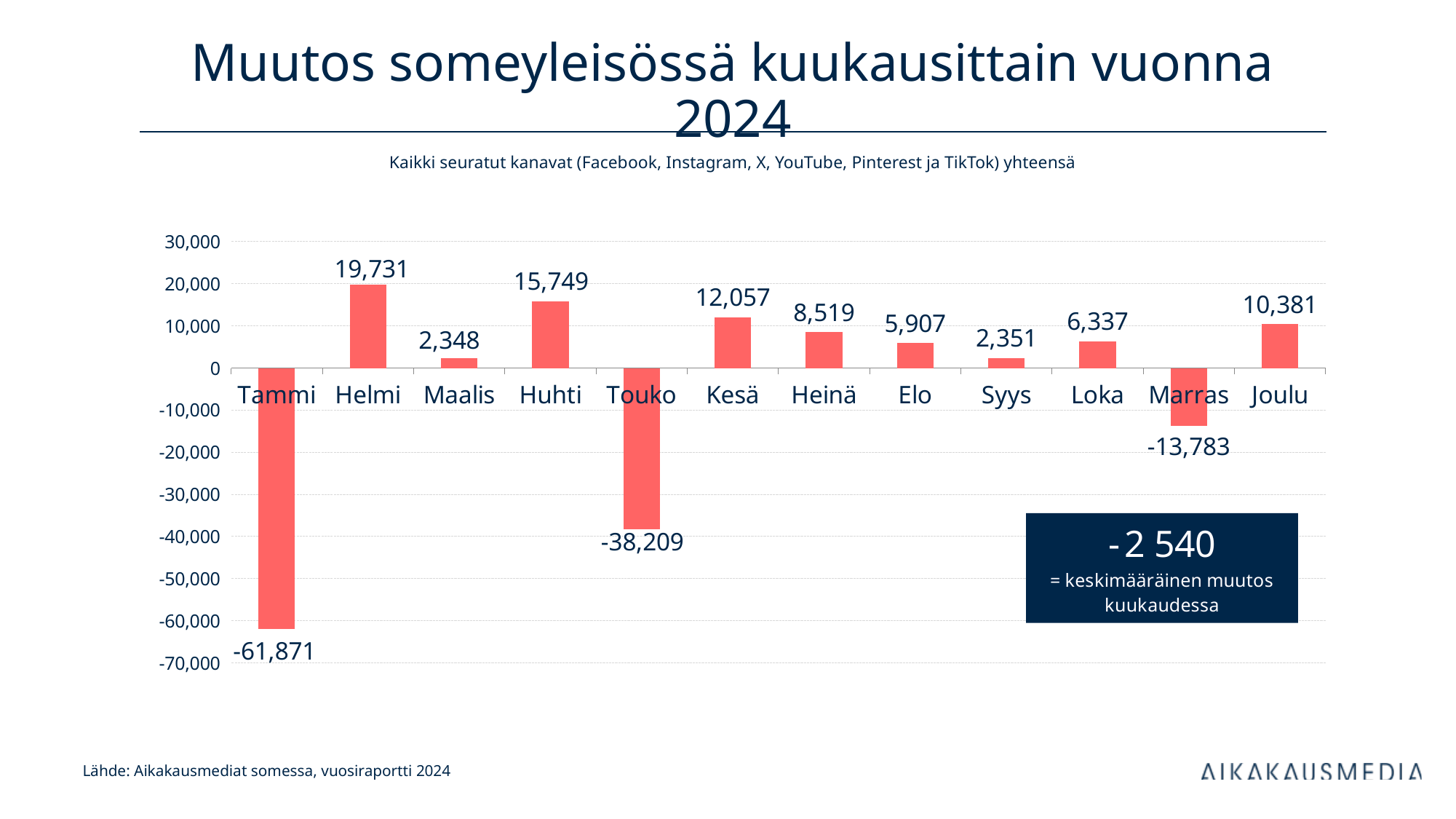
What is the value for Marras? -13,783 Which month has the highest value? Helmi Is the value for Tammi greater or less than -60,000? less Which is larger, the value for Kesä or the value for Heinä? Kesä How many months have a negative value? 3 How many months are shown on the x axis? 12 What average monthly change is stated in the box on the chart? -2 540 What is the value for Touko? -38,209 What kind of chart is shown on the slide? bar chart Which month has the lowest value? Tammi What is the value for Helmi? 19,731 What is the difference between the values for Helmi and Huhti? 3,982